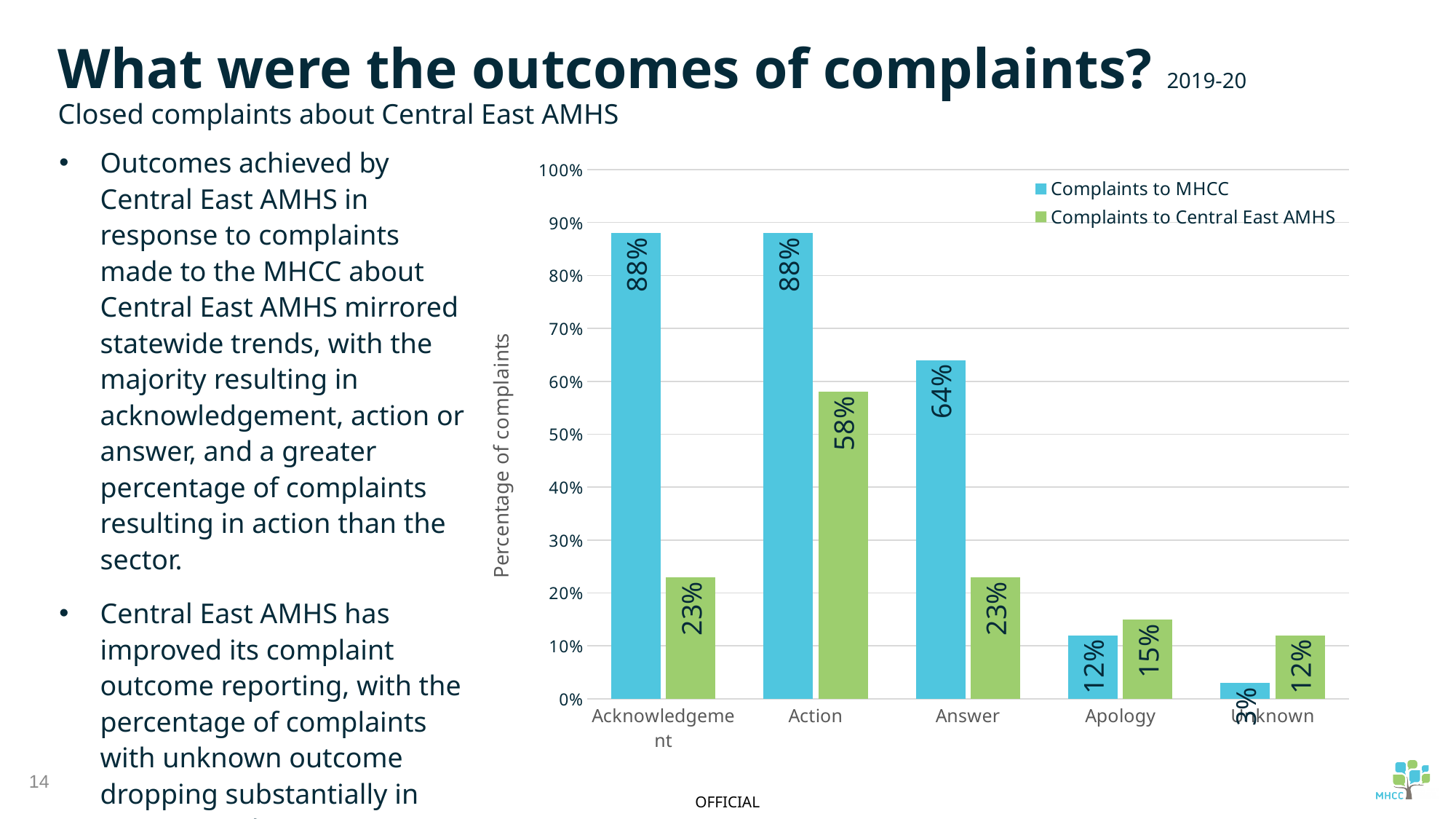
Is the value for Complaints to MHCC in the Answer category greater or less than 60%? greater What is the difference between the Complaints to MHCC and Complaints to Central East AMHS values for Acknowledgement? 65 percentage points Which outcome category has the lowest value for Complaints to MHCC? Unknown What percentage of complaints to Central East AMHS resulted in Action? 58% For Apology, which series has the larger value: Complaints to MHCC or Complaints to Central East AMHS? Complaints to Central East AMHS What percentage of complaints to Central East AMHS had an Unknown outcome? 12% What percentage of complaints to MHCC resulted in Answer? 64% What percentage of complaints to MHCC resulted in Acknowledgement? 88% What kind of chart is shown on the slide? Bar chart Which outcome category has the highest value for Complaints to Central East AMHS? Action How many series does the legend list? 2 How many outcome categories are shown on the x axis? 5